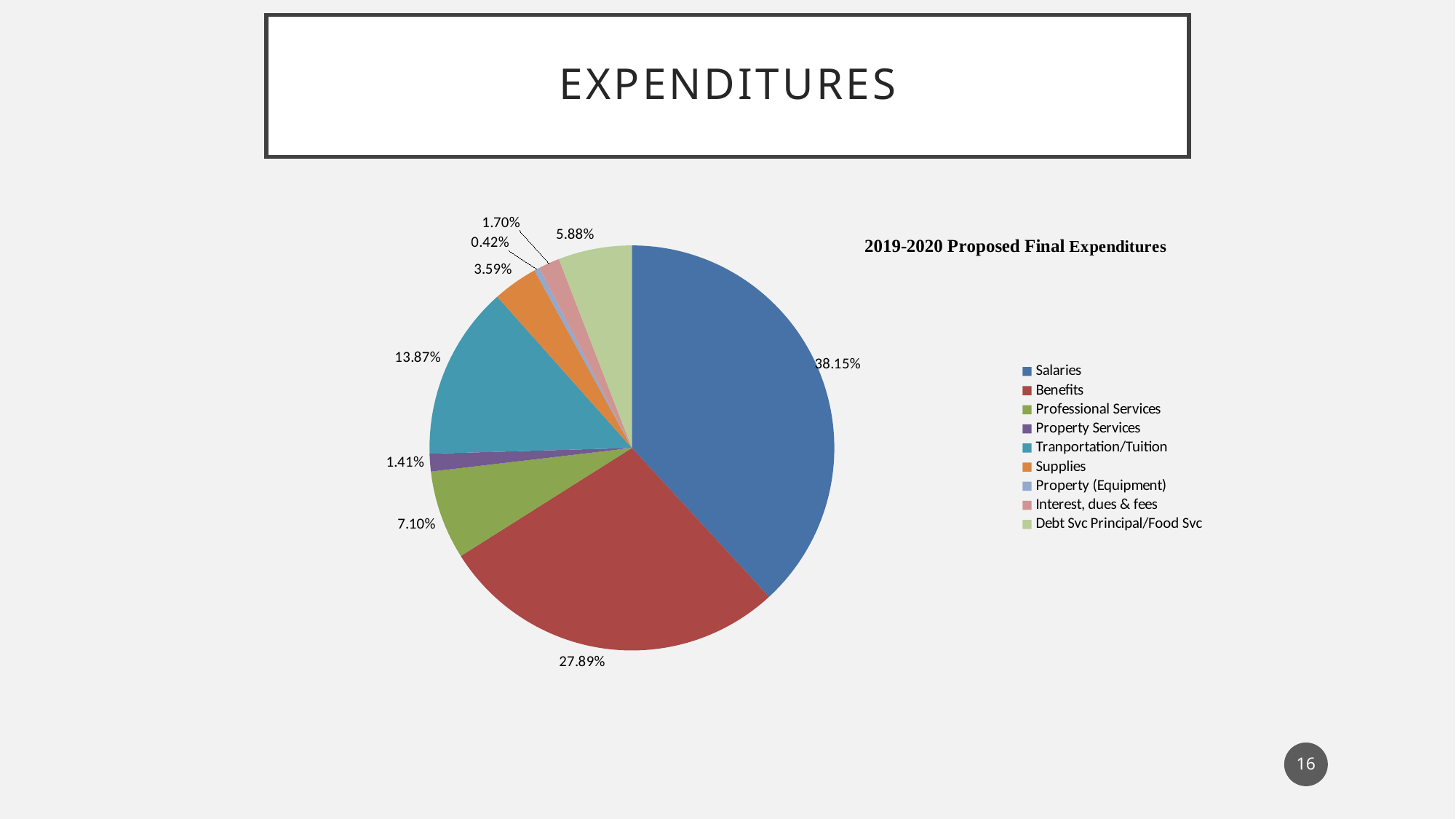
What percentage is shown for Benefits? 27.89% Which is larger, Debt Svc Principal/Food Svc or Supplies? Debt Svc Principal/Food Svc What type of chart is shown on the slide? Pie chart What is the difference in percentage points between Salaries and Benefits? 10.26 How many categories does the legend list? 9 What share of the pie does Salaries represent? 38.15% What percentage is shown for Professional Services? 7.10% What is the value for Tranportation/Tuition? 13.87% What is the title of the chart? 2019-2020 Proposed Final Expenditures Which category has the smallest slice of the pie? Property (Equipment) Which category has the largest slice of the pie? Salaries What is the value for Supplies? 3.59%